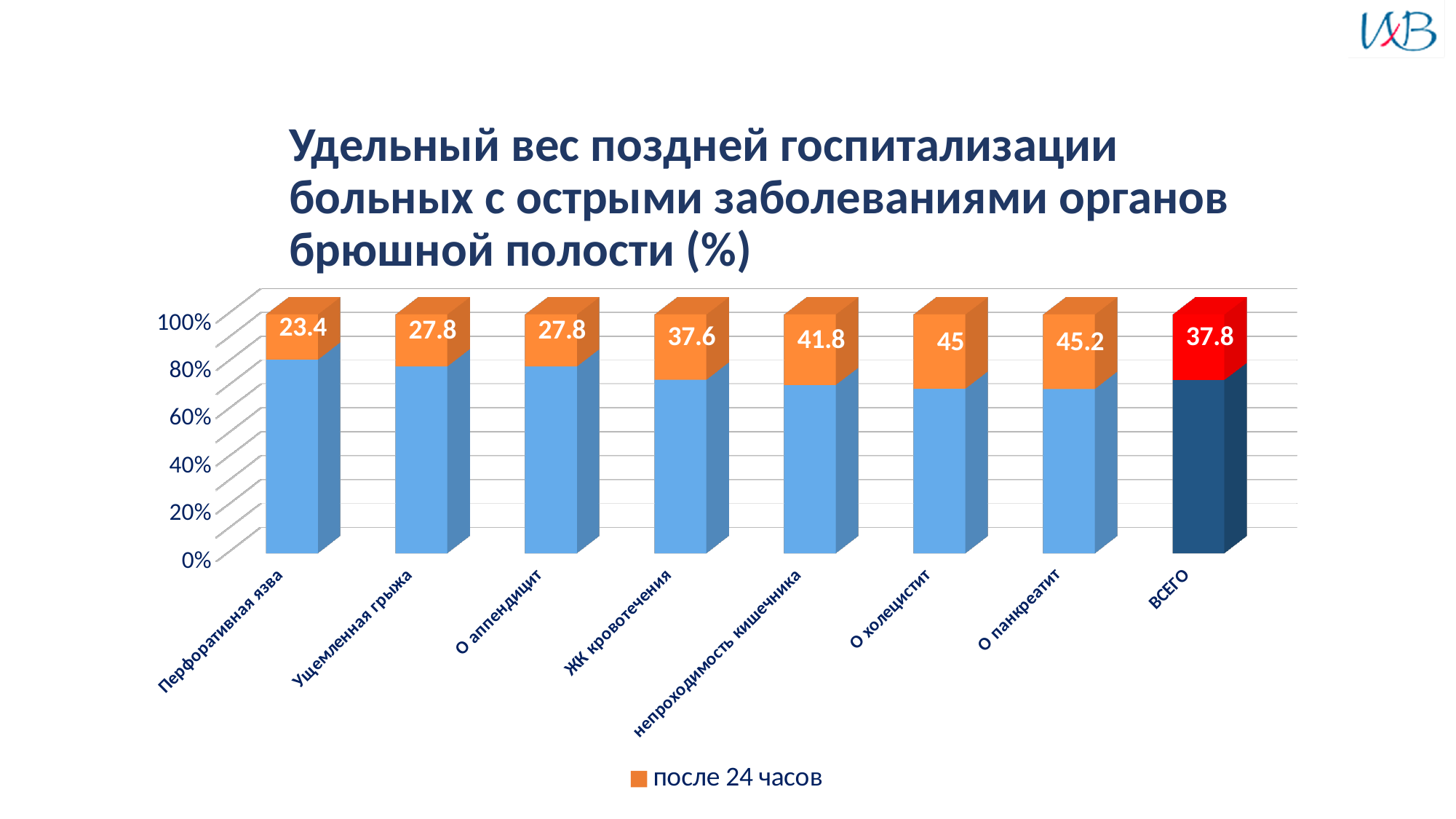
How many categories are shown on the x axis? 8 How many series does the legend list? 1 What is the value labelled for О холецистит? 45 What is the value labelled for непроходимость кишечника? 41.8 What kind of chart is shown on the slide? Stacked bar chart Which has the larger labelled value, О холецистит or ЖК кровотечения? О холецистит Which category has the lowest labelled value? Перфоративная язва What is the value labelled for Перфоративная язва? 23.4 What is the difference between the labelled values for ЖК кровотечения and Ущемленная грыжа? 9.8 Which category has the highest labelled value? О панкреатит What is the value labelled for the ВСЕГО bar? 37.8 What is the difference between the labelled values for О панкреатит and Перфоративная язва? 21.8